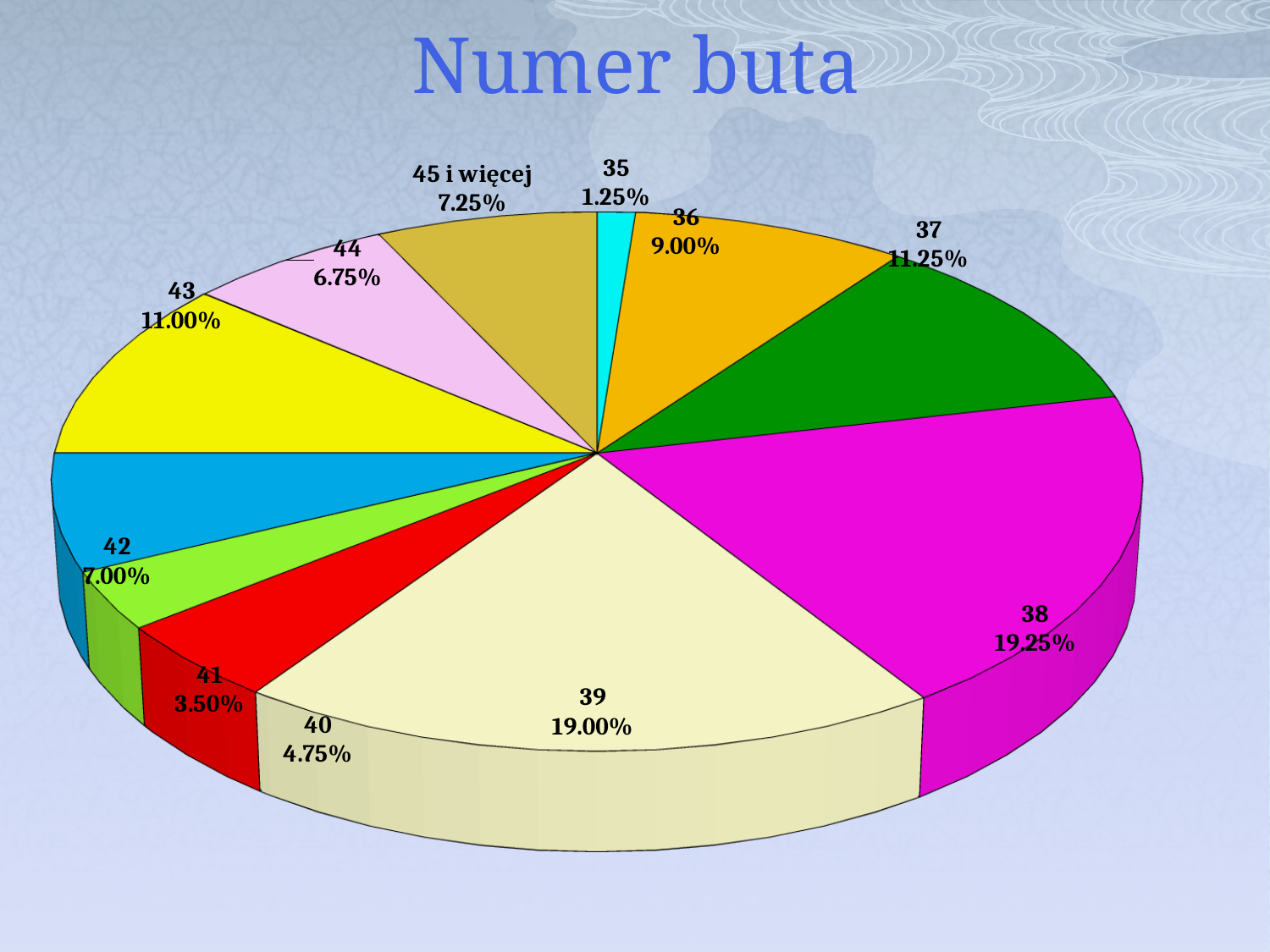
What is the value shown for shoe size 39? 19.00% How many slices does the pie chart have? 11 What is the value shown for shoe size 42? 7.00% What is the title of the chart? Numer buta What is the difference between the shares for shoe sizes 40 and 41? 1.25% Which shoe size has the largest share of the pie? 38 Which shoe size has the smallest share of the pie? 35 What share of the pie does shoe size 38 have? 19.25% What is the value shown for the category '45 i więcej'? 7.25% Which has a larger share, shoe size 36 or shoe size 44? 36 What type of chart is shown on the slide? pie chart What is the difference between the shares for shoe sizes 37 and 43? 0.25%